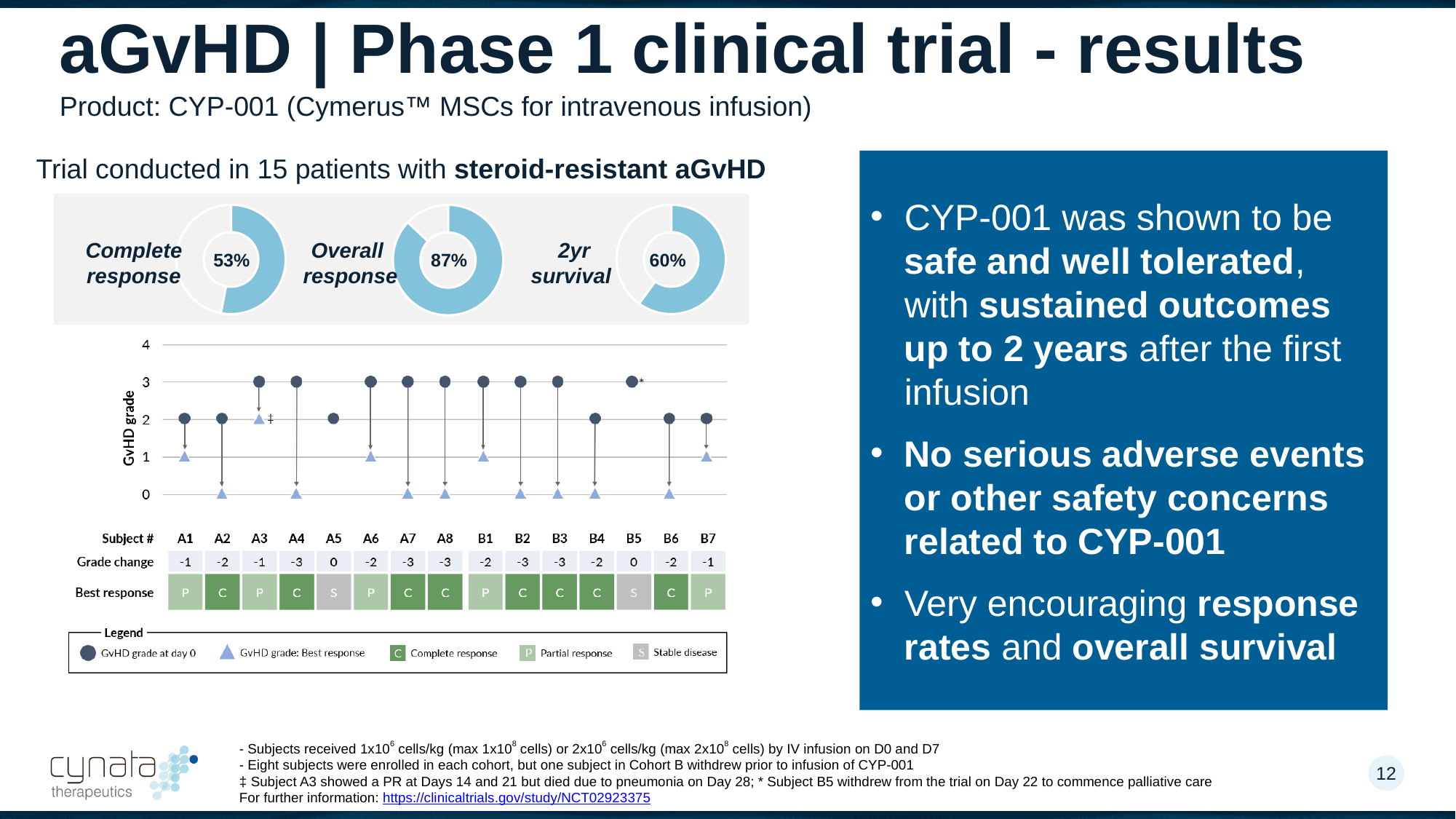
In the donut charts, what is the difference between the Overall response rate and the Complete response rate? 34 percentage points In the GvHD grade chart, how many entries does the legend list? 5 In the donut charts, which is larger: 2yr survival or Complete response? 2yr survival In the GvHD grade chart, what was subject A4's GvHD grade at best response? 0 Among the three donut charts, which metric has the lowest percentage? Complete response Among the three donut charts, which metric has the highest percentage? Overall response In the GvHD grade chart, what was subject A1's GvHD grade at day 0? 2 In the donut charts at the top, what is the 2yr survival rate? 60% In the donut charts at the top, what is the Complete response rate? 53% In the table below the GvHD grade chart, what is the grade change for subject B2? -3 In the donut charts at the top, what is the Overall response rate? 87% In the GvHD grade chart, how many subjects are plotted along the x axis? 15